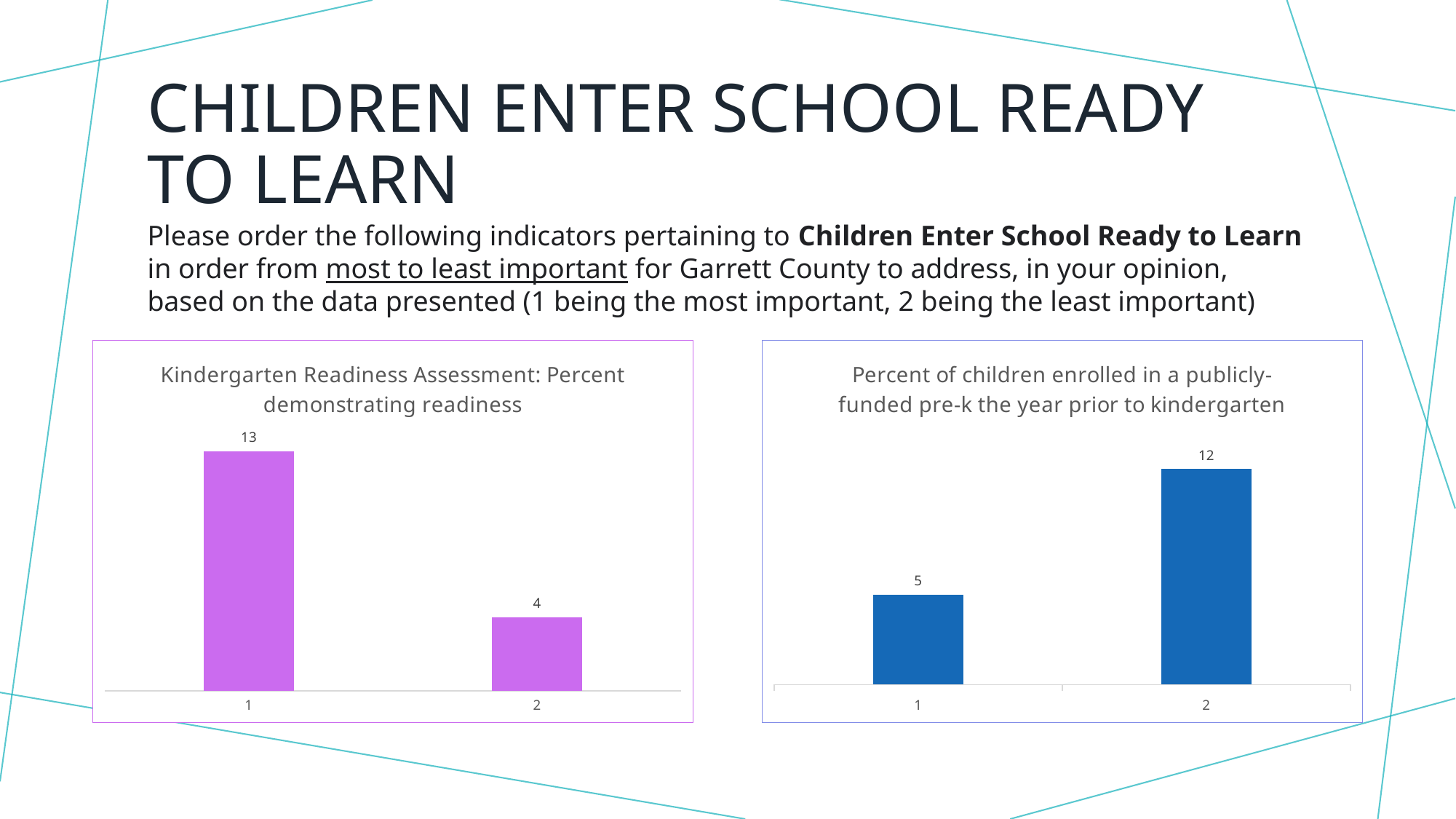
In the 'Kindergarten Readiness Assessment: Percent demonstrating readiness' chart, what is the value for category 1? 13 In the 'Kindergarten Readiness Assessment: Percent demonstrating readiness' chart, what is the value for category 2? 4 In the 'Percent of children enrolled in a publicly-funded pre-k the year prior to kindergarten' chart, what is the value for category 2? 12 In the 'Percent of children enrolled in a publicly-funded pre-k the year prior to kindergarten' chart, what is the difference between the values for category 2 and category 1? 7 In the 'Percent of children enrolled in a publicly-funded pre-k the year prior to kindergarten' chart, which category has the lowest value? 1 How many categories are shown in the 'Kindergarten Readiness Assessment: Percent demonstrating readiness' chart? 2 In the 'Percent of children enrolled in a publicly-funded pre-k the year prior to kindergarten' chart, what is the value for category 1? 5 In the 'Kindergarten Readiness Assessment: Percent demonstrating readiness' chart, what is the difference between the values for category 1 and category 2? 9 In the 'Percent of children enrolled in a publicly-funded pre-k the year prior to kindergarten' chart, which category has the larger value, 1 or 2? 2 What colour are the bars in the 'Kindergarten Readiness Assessment: Percent demonstrating readiness' chart? Purple In the 'Kindergarten Readiness Assessment: Percent demonstrating readiness' chart, which category has the highest value? 1 What kind of chart is the 'Percent of children enrolled in a publicly-funded pre-k the year prior to kindergarten' chart? Bar chart